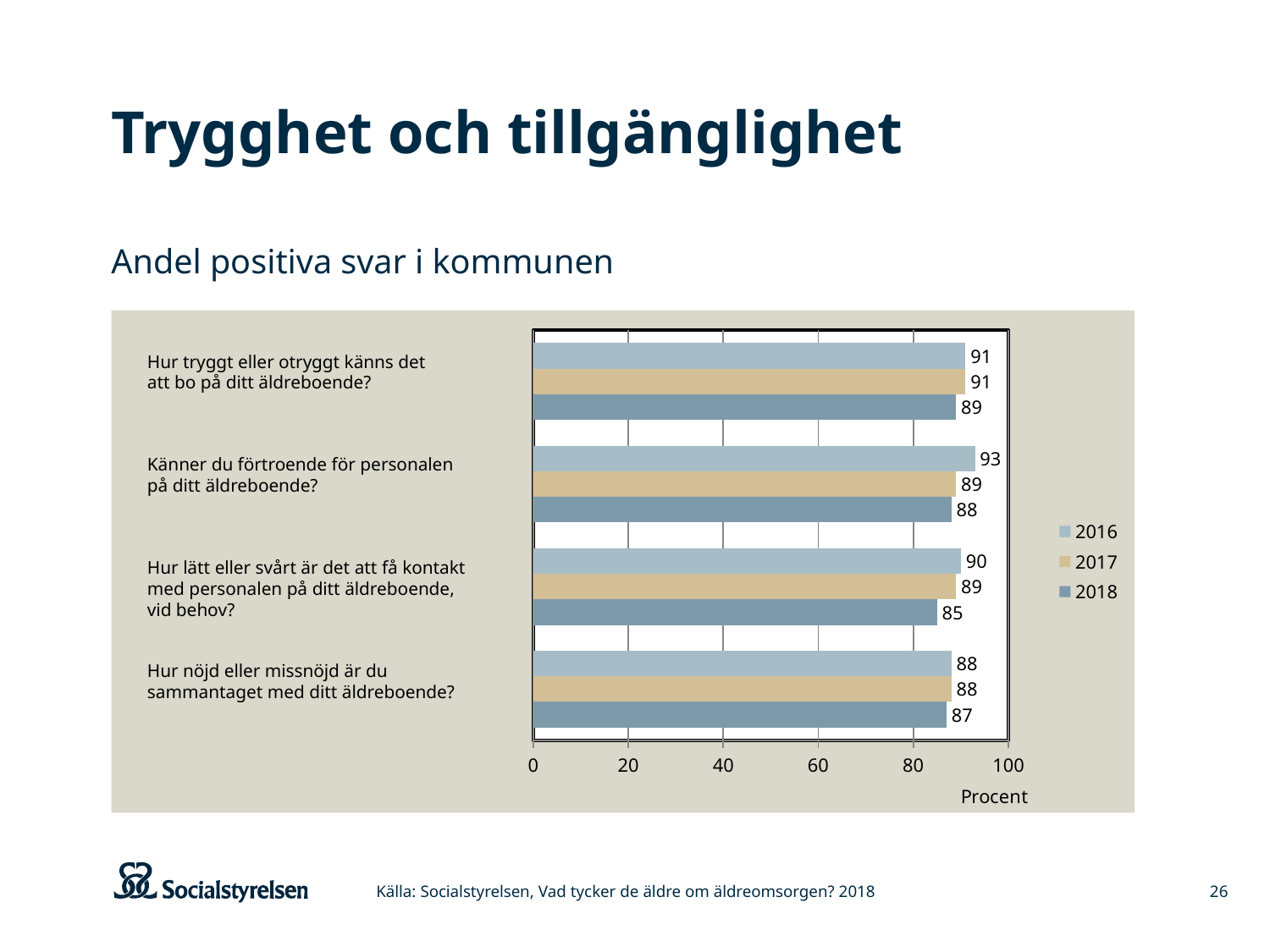
What kind of chart is shown on the slide? Bar chart What is the 2017 value for "Hur tryggt eller otryggt känns det att bo på ditt äldreboende?"? 91 What is the 2018 value for "Hur lätt eller svårt är det att få kontakt med personalen på ditt äldreboende, vid behov?"? 85 How many questions (categories) are shown in the chart? 4 What is the label on the horizontal axis of the chart? Procent Which question has the highest 2016 value? Känner du förtroende för personalen på ditt äldreboende? What is the 2016 value for "Känner du förtroende för personalen på ditt äldreboende?"? 93 How many series does the legend list? 3 What is the difference between the 2016 and 2018 values for "Känner du förtroende för personalen på ditt äldreboende?"? 5 Which is larger for "Hur lätt eller svårt är det att få kontakt med personalen på ditt äldreboende, vid behov?": the 2016 value or the 2018 value? 2016 Which question has the lowest 2018 value? Hur lätt eller svårt är det att få kontakt med personalen på ditt äldreboende, vid behov? What is the 2018 value for "Hur nöjd eller missnöjd är du sammantaget med ditt äldreboende?"? 87